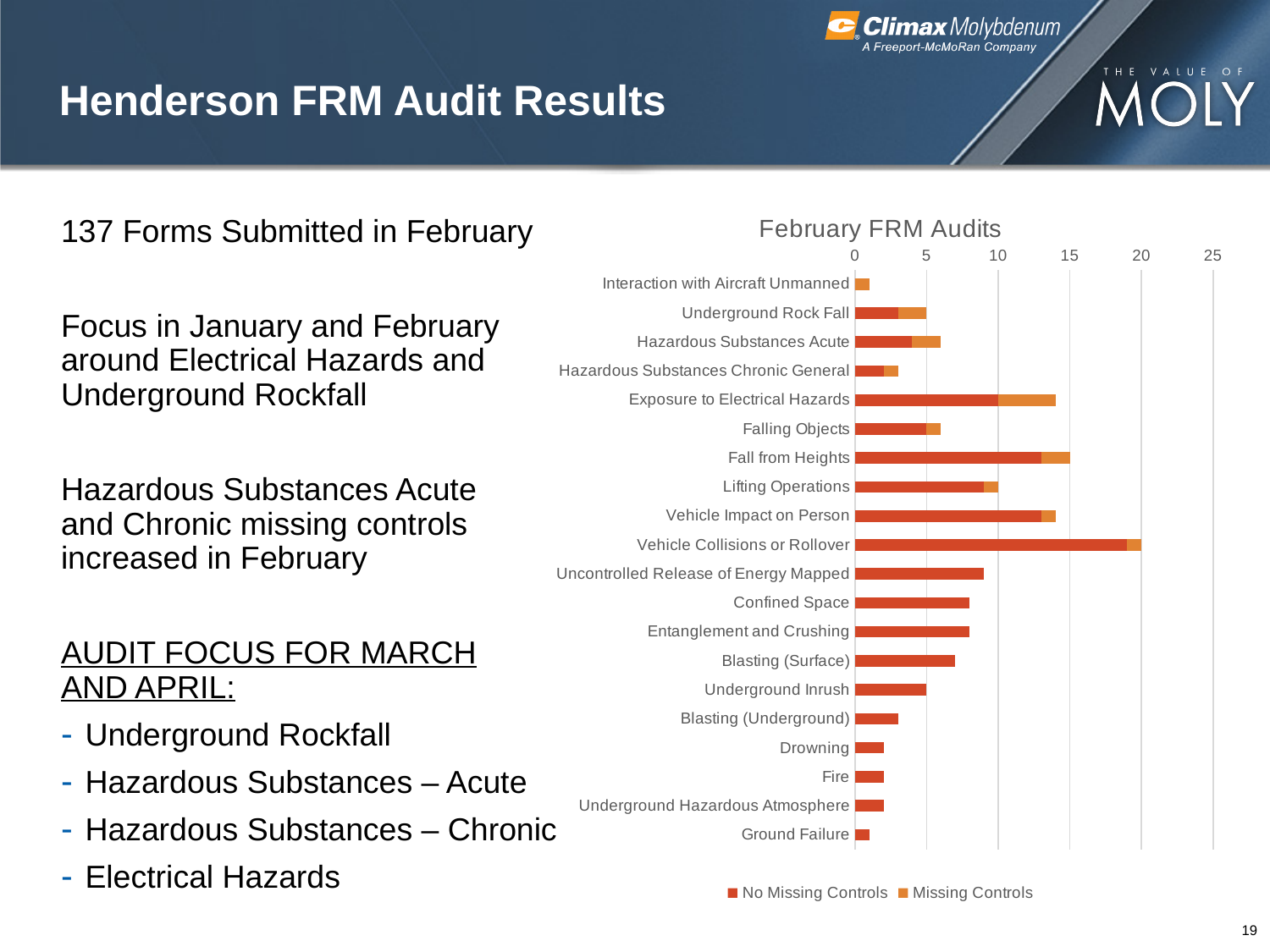
How many series does the chart legend list? 2 How many categories are plotted in the February FRM Audits chart? 20 What is the title of the chart? February FRM Audits Is the total bar for Vehicle Collisions or Rollover greater or less than 15? greater Which has the longer total bar, Exposure to Electrical Hazards or Falling Objects? Exposure to Electrical Hazards Which series is shown in orange in the chart legend? Missing Controls What kind of chart is shown on the slide? Bar chart Which has the longer total bar, Vehicle Collisions or Rollover or Fall from Heights? Vehicle Collisions or Rollover Which category has the longest total bar in the February FRM Audits chart? Vehicle Collisions or Rollover Is the total bar for Confined Space greater or less than 10? less Is the total bar for Drowning greater or less than 5? less